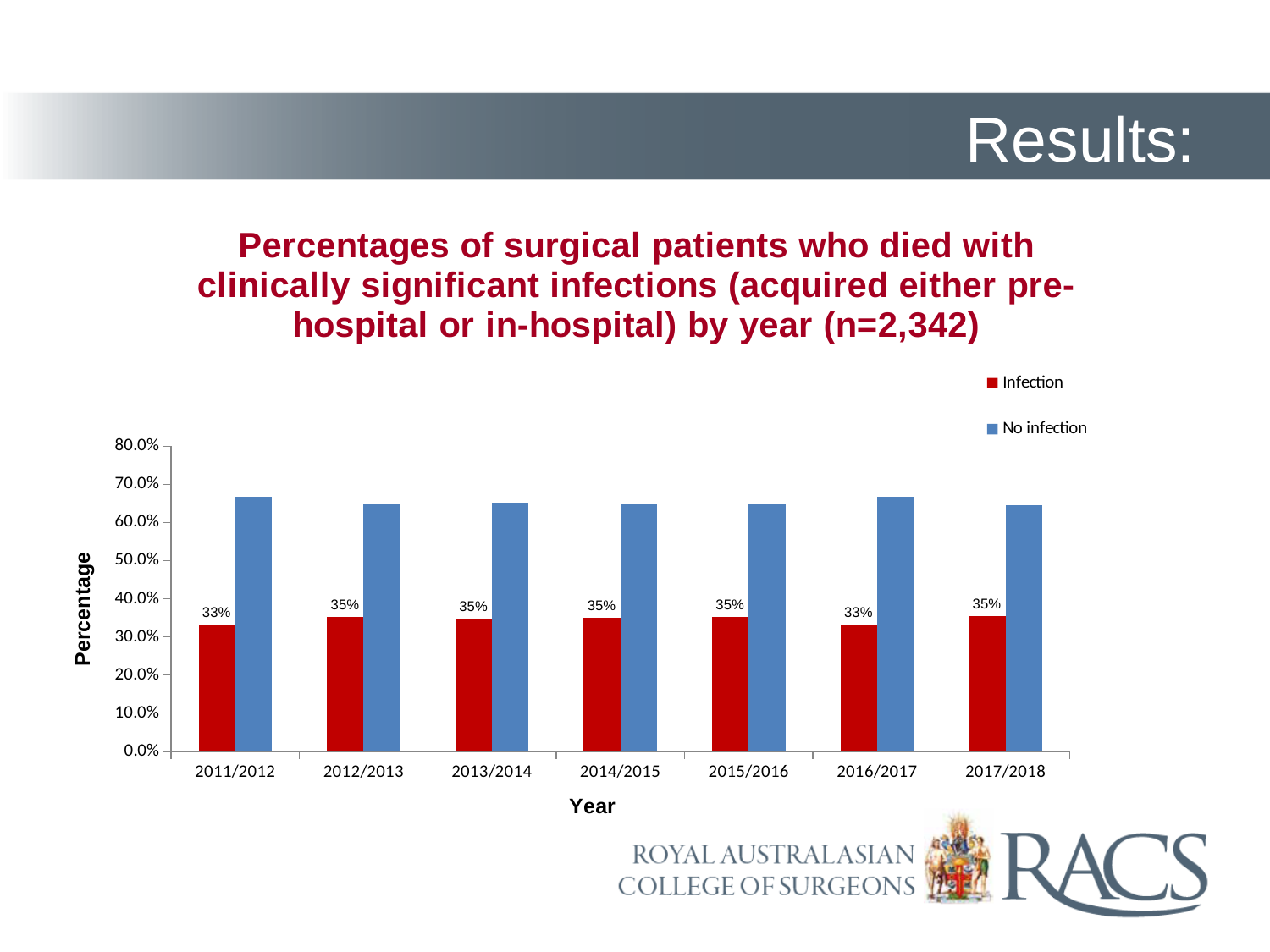
What is the Infection percentage for 2011/2012? 33% What is the difference between the Infection percentage in 2012/2013 and in 2011/2012? 2% What is the Infection percentage for 2016/2017? 33% What is the Infection percentage for 2014/2015? 35% What is the Infection percentage for 2017/2018? 35% Which colour represents the Infection series in the legend? red How many years are shown on the x axis? 7 How many series does the legend list? 2 What type of chart is shown on the slide? bar chart In 2013/2014, which is larger, the Infection bar or the No infection bar? No infection Is the No infection value for 2011/2012 greater or less than 60.0%? greater Is the No infection value for 2017/2018 greater or less than 70.0%? less